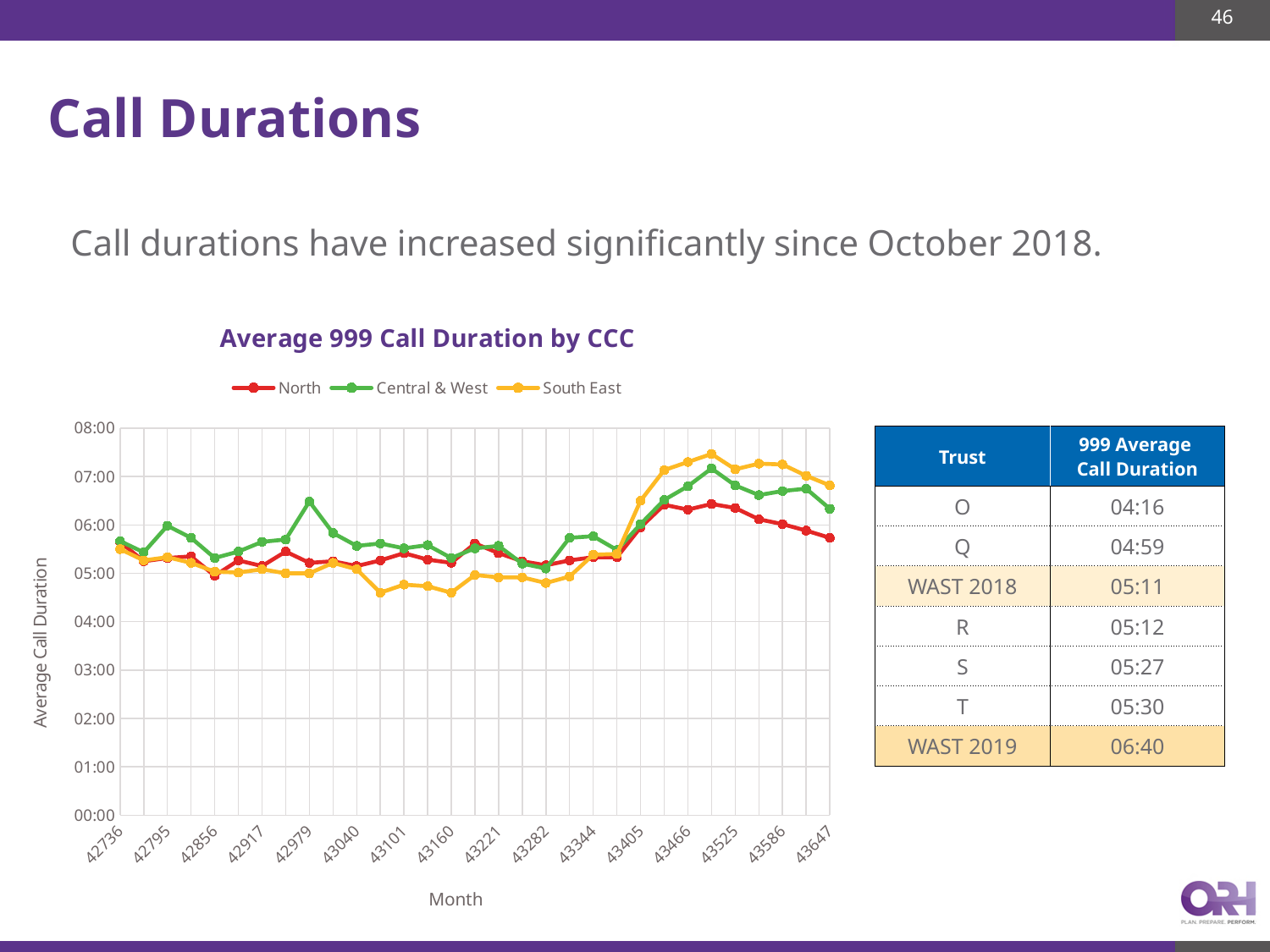
Is the value for South East at 43525 greater or less than 07:00? greater Is the value for Central & West at 42979 greater or less than 06:00? greater Is the value for North at 43647 greater or less than 06:00? less Do the values for North rise or fall between 43405 and 43466? rise Which series are listed in the chart's legend? North, Central & West, South East At 43525, which series has the highest value? South East At 42979, which is larger: the value for Central & West or the value for North? Central & West What kind of chart is shown on the slide? line chart What is the title of the chart? Average 999 Call Duration by CCC How many series does the legend of the chart list? 3 At 43101, which series has the lowest value? South East